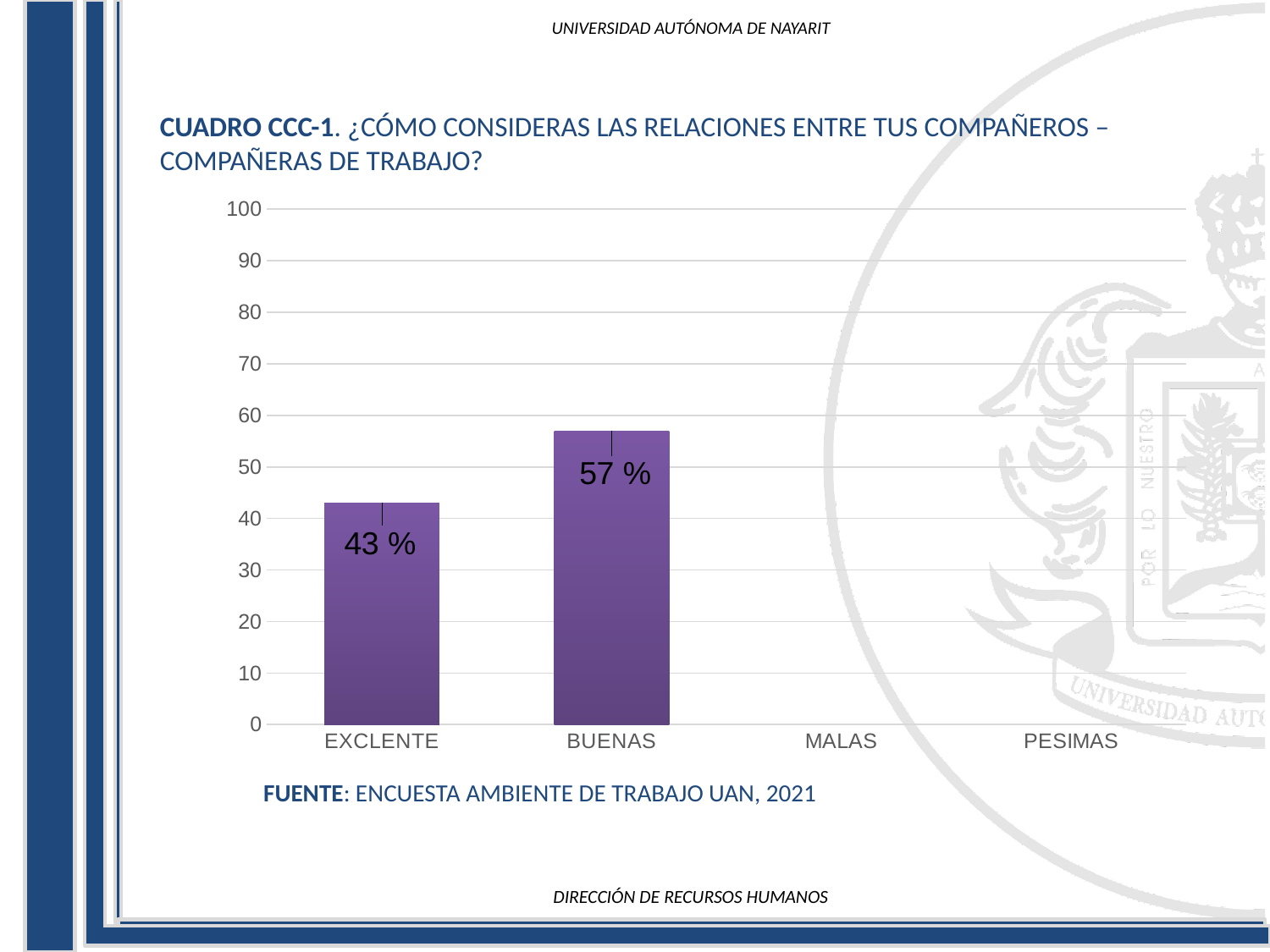
What is the highest value shown on the y axis? 100 What is the value for BUENAS? 57 % Which category has the highest value? BUENAS Which is larger, the value for EXCLENTE or the value for BUENAS? BUENAS How many categories are shown on the x axis? 4 What is the total of the values for EXCLENTE and BUENAS? 100 % What is the difference between the values for BUENAS and EXCLENTE? 14 % Is the value for BUENAS greater or less than 50? greater Is the value for EXCLENTE greater or less than 50? less What kind of chart is shown on the slide? bar chart What is the source cited below the chart? ENCUESTA AMBIENTE DE TRABAJO UAN, 2021 What is the value for EXCLENTE? 43 %